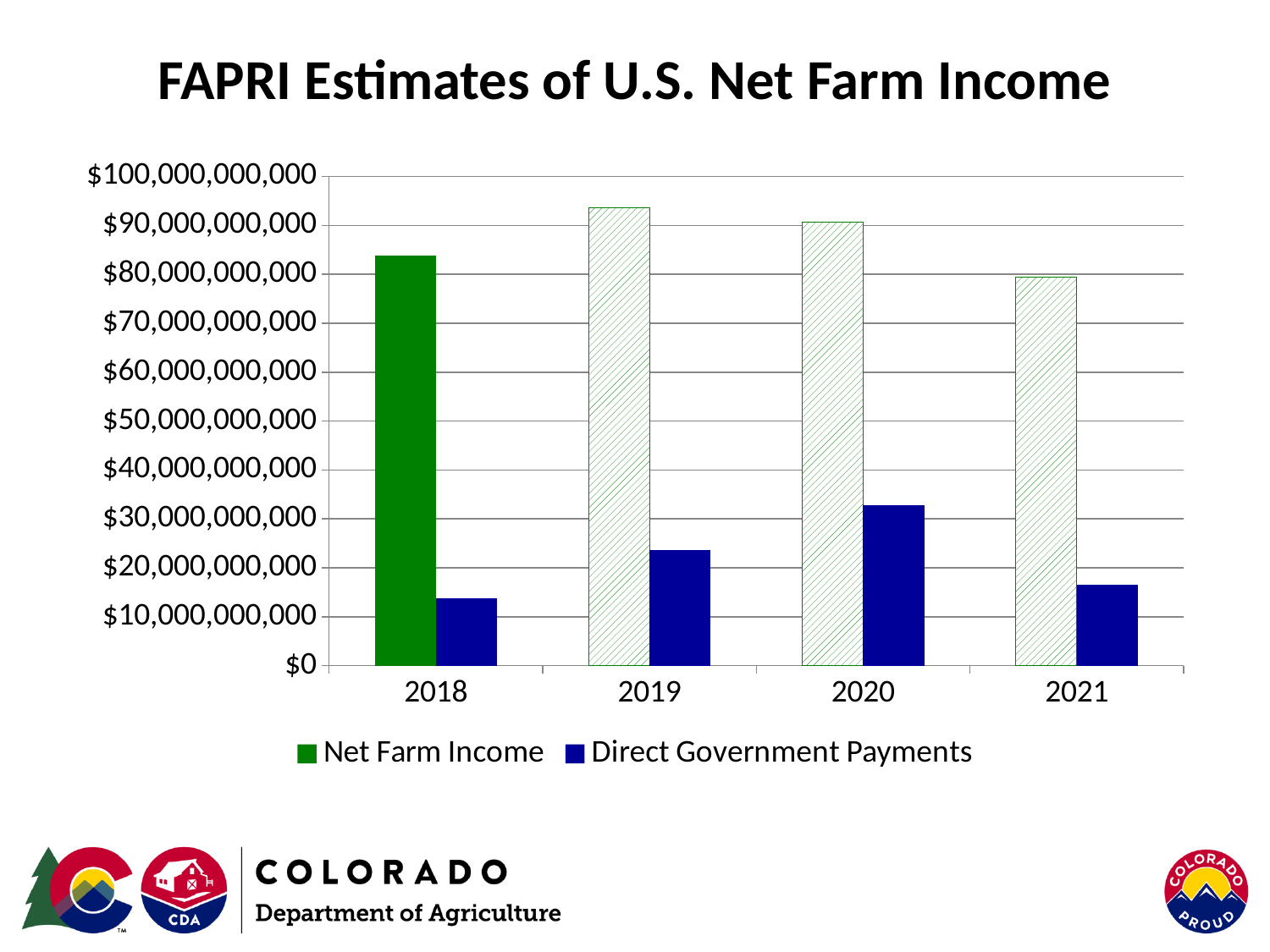
Which year has the highest Direct Government Payments? 2020 What is the title of the chart? FAPRI Estimates of U.S. Net Farm Income How many years are shown on the x axis? 4 Which is larger: Net Farm Income in 2019 or Net Farm Income in 2021? 2019 Is the Direct Government Payments value for 2020 greater or less than $30,000,000,000? greater Do Direct Government Payments rise or fall from 2018 to 2020? rise Is the Net Farm Income for 2018 greater or less than $90,000,000,000? less Which year has the lowest Net Farm Income? 2021 How many series does the legend list? 2 Is the Direct Government Payments value for 2019 greater or less than $20,000,000,000? greater What type of chart is shown on the slide? Bar chart Which year has the lowest Direct Government Payments? 2018